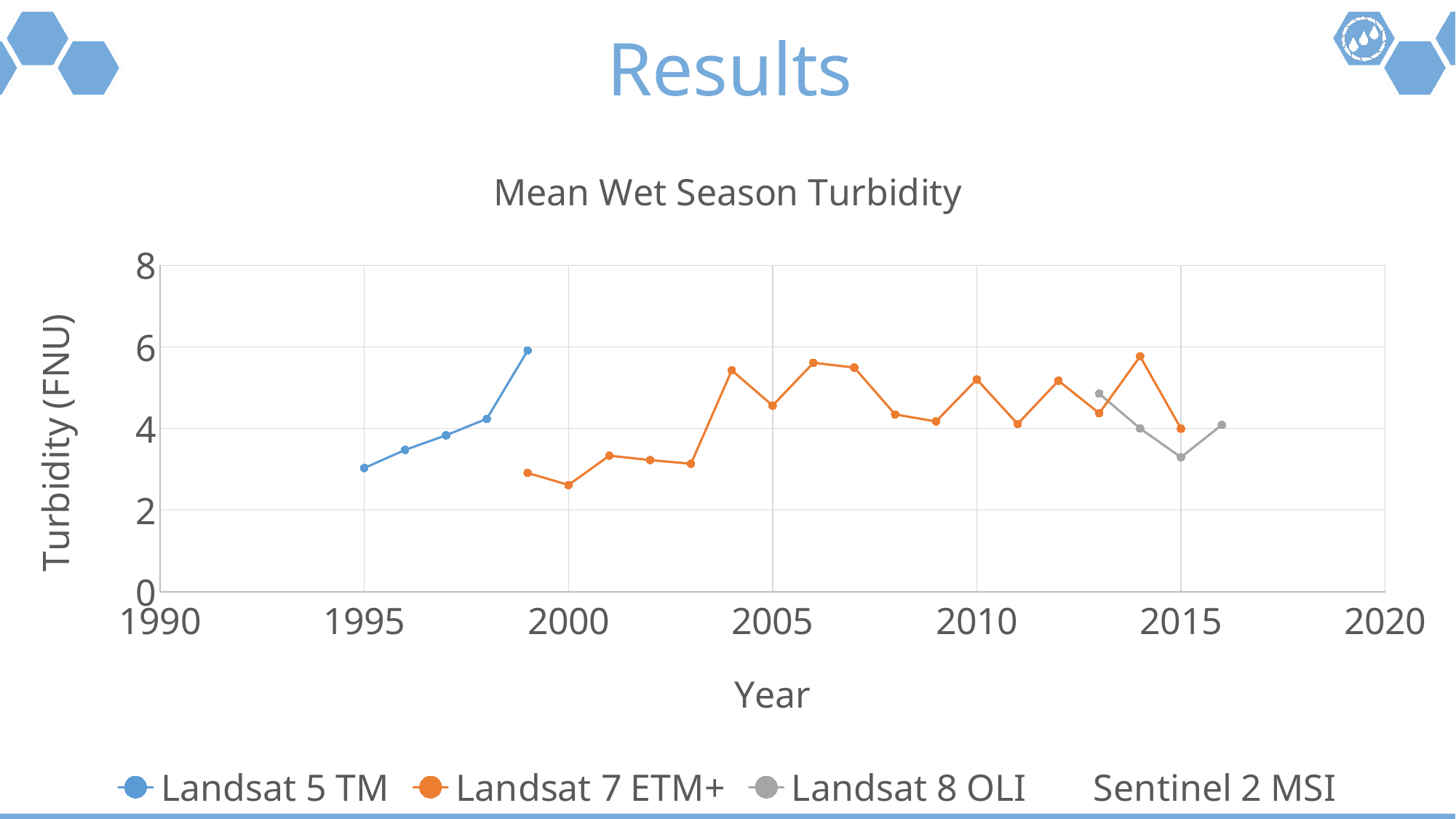
Is the Landsat 8 OLI value for 2015 greater or less than 4? less How many data points are plotted for the Landsat 8 OLI series? 4 What is the title of the chart? Mean Wet Season Turbidity How many data points are plotted for the Landsat 5 TM series? 5 Which is larger for Landsat 7 ETM+: the value in 2004 or the value in 2000? 2004 Is the Landsat 5 TM value for 1999 greater or less than 4? greater How many series does the legend list? 4 Do the Landsat 5 TM values rise or fall from 1995 to 1999? rise What is the label of the y axis? Turbidity (FNU) What kind of chart is shown on the slide? line chart Is the Landsat 7 ETM+ value for 2000 greater or less than 4? less In which year is the Landsat 7 ETM+ series at its lowest? 2000